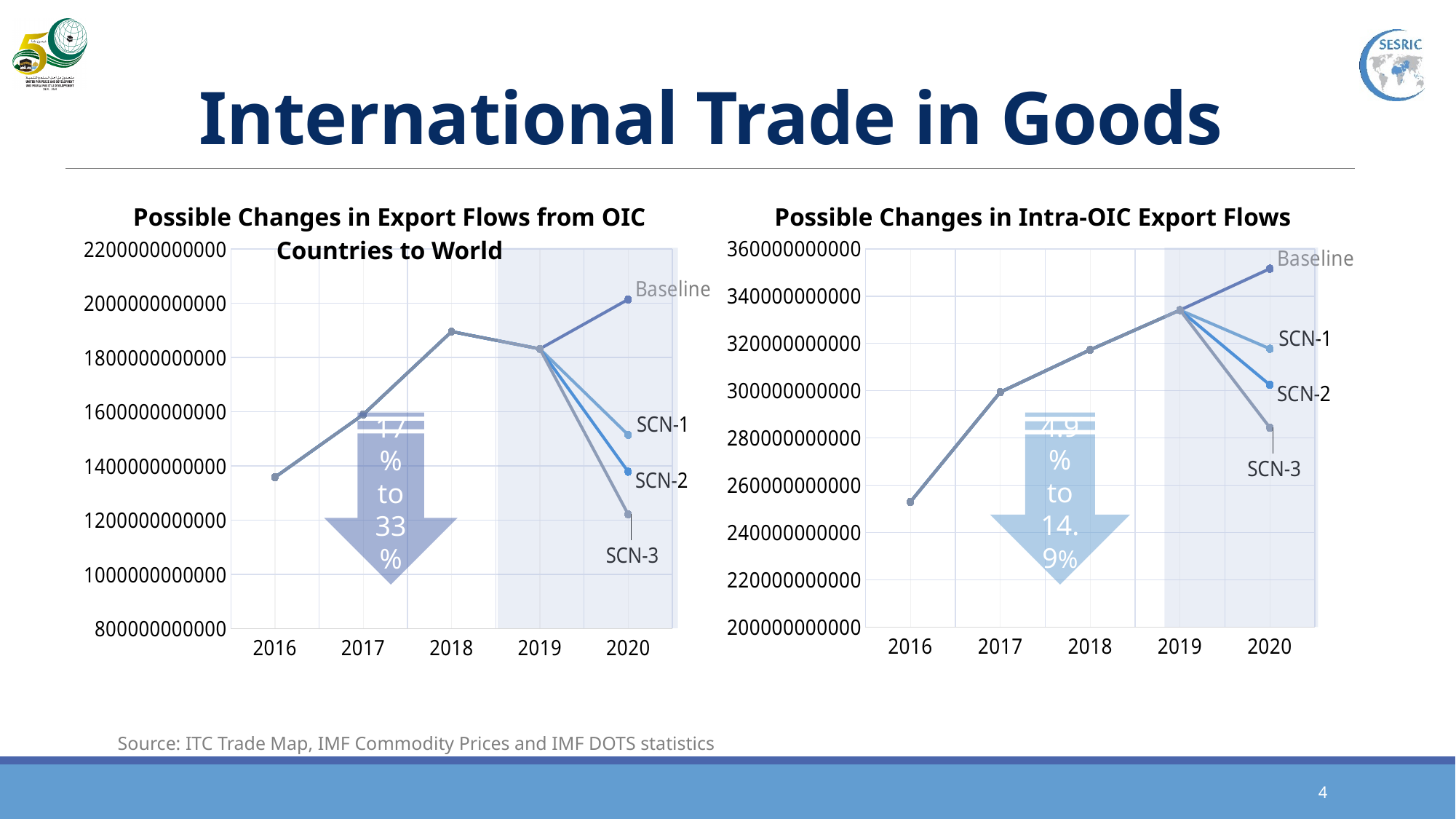
In the chart 'Possible Changes in Export Flows from OIC Countries to World', how many years are shown on the x axis? 5 What kind of chart is 'Possible Changes in Intra-OIC Export Flows'? line chart In the chart 'Possible Changes in Export Flows from OIC Countries to World', is the value for 2016 greater or less than 1400000000000? less In the chart 'Possible Changes in Export Flows from OIC Countries to World', which year has the larger value, 2018 or 2019? 2018 What kind of chart is 'Possible Changes in Export Flows from OIC Countries to World'? line chart In the chart 'Possible Changes in Intra-OIC Export Flows', is the value for 2019 greater or less than 320000000000? greater In the chart 'Possible Changes in Export Flows from OIC Countries to World', which 2020 scenario line ends at the highest value? Baseline In the chart 'Possible Changes in Intra-OIC Export Flows', how many labelled scenario lines branch out in 2020? 4 In the chart 'Possible Changes in Export Flows from OIC Countries to World', do the values rise or fall from 2016 to 2018? rise In the chart 'Possible Changes in Export Flows from OIC Countries to World', which 2020 scenario line ends at the lowest value? SCN-3 In the chart 'Possible Changes in Intra-OIC Export Flows', is the value for 2016 greater or less than 260000000000? less